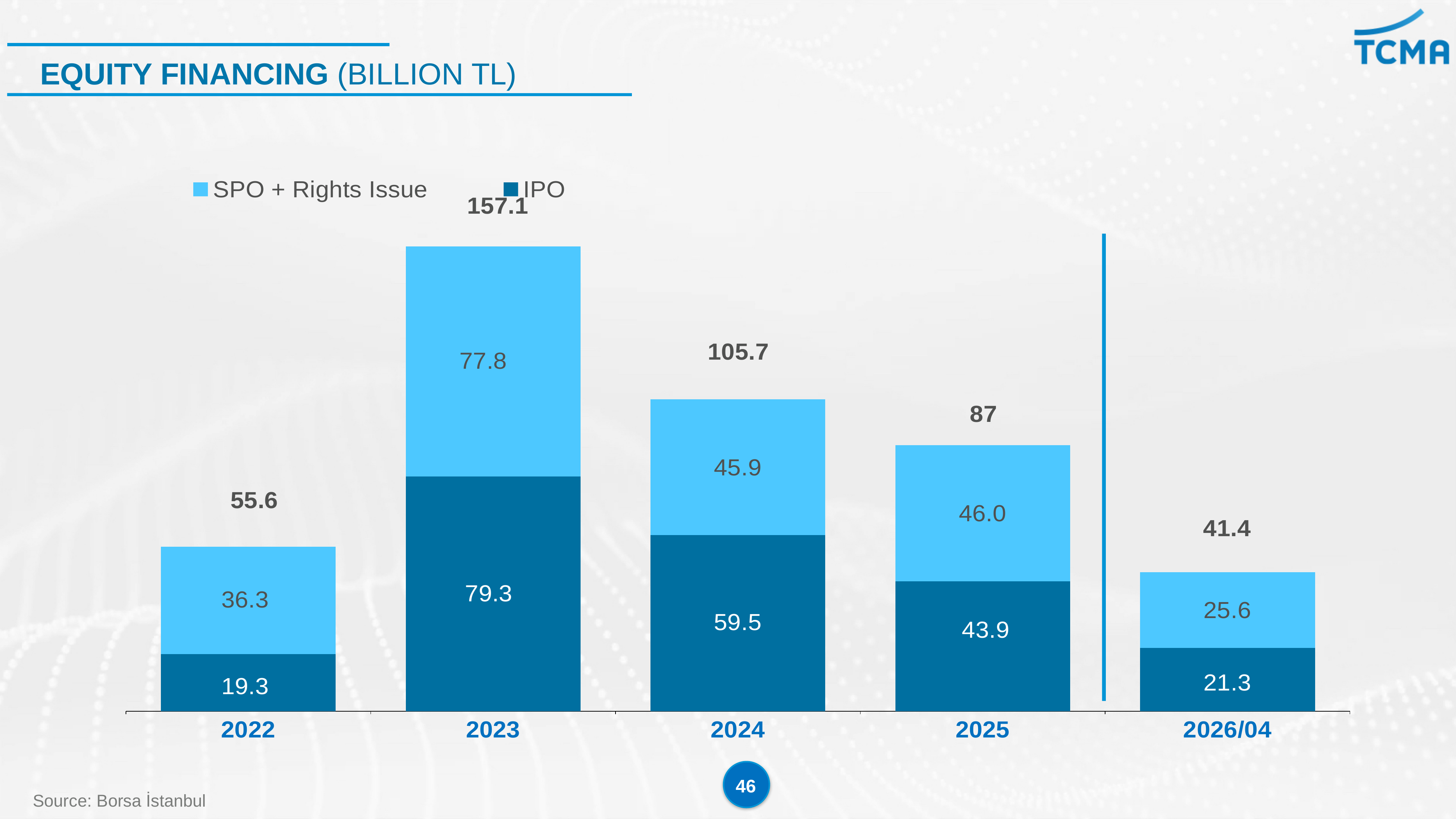
Which period has the lowest IPO value? 2022 How many periods are shown on the x axis? 5 How many series does the legend list? 2 What is the IPO value for 2023? 79.3 What is the difference between the total for 2023 and the total for 2024? 51.4 Which is larger, the IPO value for 2024 or the IPO value for 2025? 2024 What is the IPO value for 2026/04? 21.3 What kind of chart is shown on the slide? Stacked bar chart What is the SPO + Rights Issue value for 2024? 45.9 What is the total equity financing shown for 2025? 87 Which year has the highest total equity financing? 2023 What is the unit stated in the chart title? Billion TL